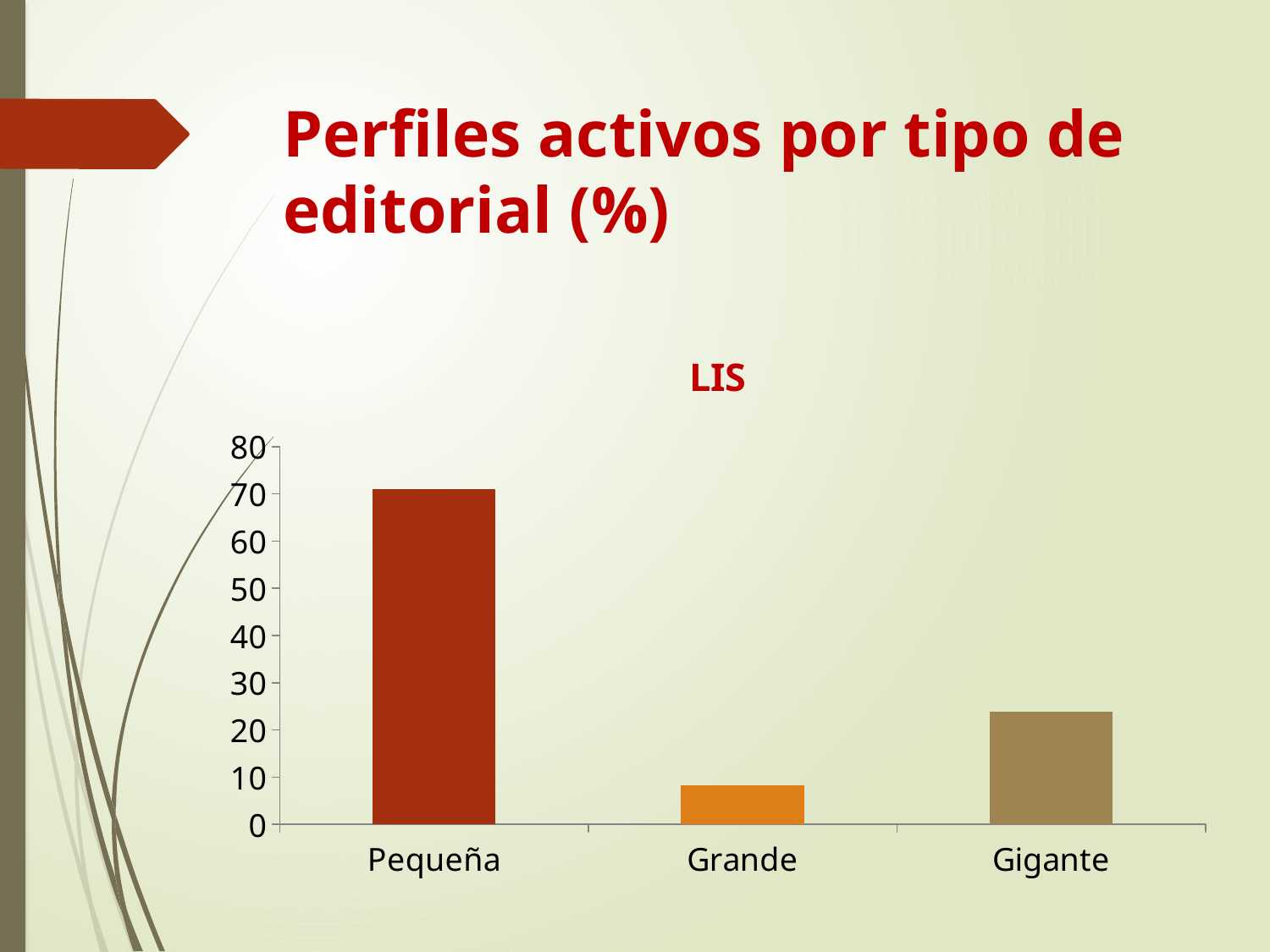
Is the value for Gigante greater or less than 30? less Which is larger, the value for Gigante or the value for Grande? Gigante What is the highest value shown on the vertical axis of the chart? 80 Which is larger, the value for Pequeña or the value for Gigante? Pequeña Is the value for Gigante greater or less than 20? greater Is the value for Grande greater or less than 10? less Which category has the highest value in the chart? Pequeña What is the title of the chart? LIS What kind of chart is shown on the slide? bar chart Which category has the lowest value in the chart? Grande How many categories are shown on the x axis of the chart? 3